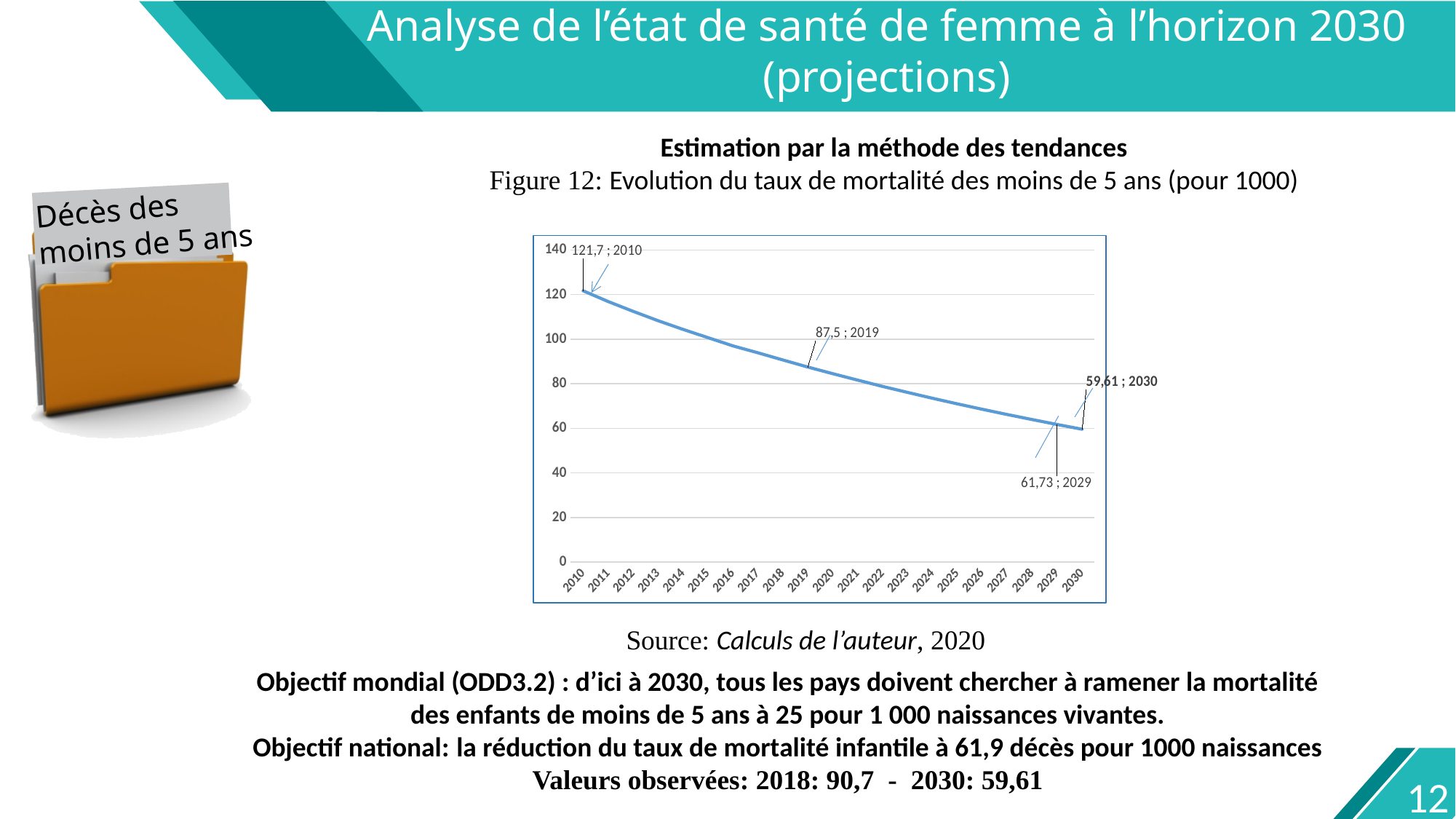
What is the under-5 mortality rate plotted for 2010? 121,7 Is the value for 2025 greater or less than 80? less How many years are shown on the x axis? 21 What type of chart is shown in Figure 12? line chart Which year has the highest value on the chart? 2010 What is the value plotted for 2019? 87,5 What is the value plotted for 2030? 59,61 What is the difference between the values for 2019 and 2029? 25,77 Do the values rise or fall from 2010 to 2030? fall What is the value plotted for 2029? 61,73 What is the difference between the values for 2010 and 2030? 62,09 Which year has the lowest value on the chart? 2030